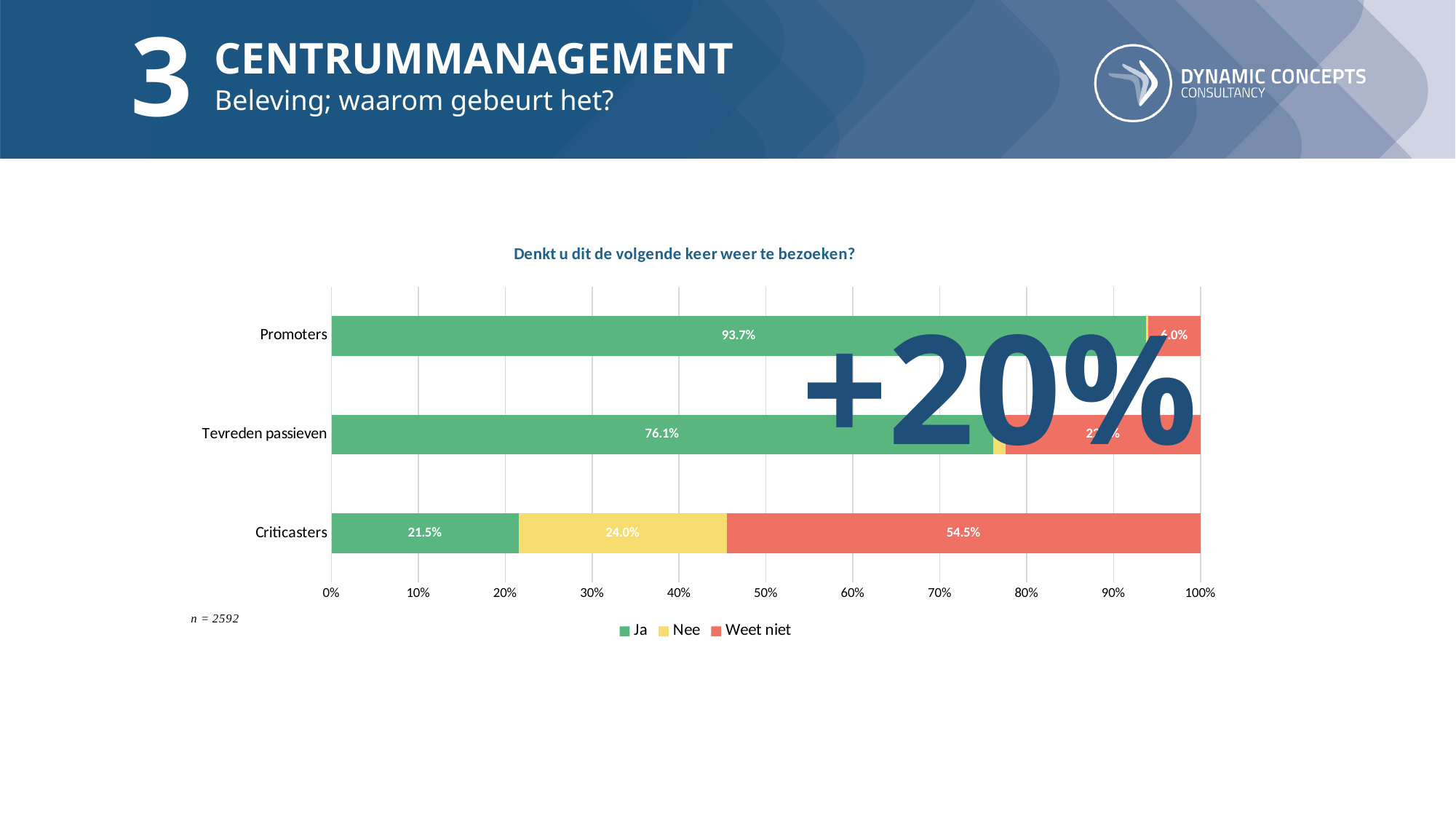
Which category has the highest value for Ja? Promoters Is the value for Weet niet for Promoters greater or less than 10%? less Which category has the lowest value for Ja? Criticasters What is the difference between the Ja values for Promoters and Tevreden passieven? 17.6% What is the value for Nee for Criticasters? 24.0% How many series does the legend list? 3 What is the value for Ja for Tevreden passieven? 76.1% For Criticasters, which is larger: Nee or Weet niet? Weet niet What is the value for Weet niet for Criticasters? 54.5% What is the value for Ja for Promoters? 93.7% What kind of chart is shown on the slide? Stacked bar chart How many categories are shown on the y axis? 3